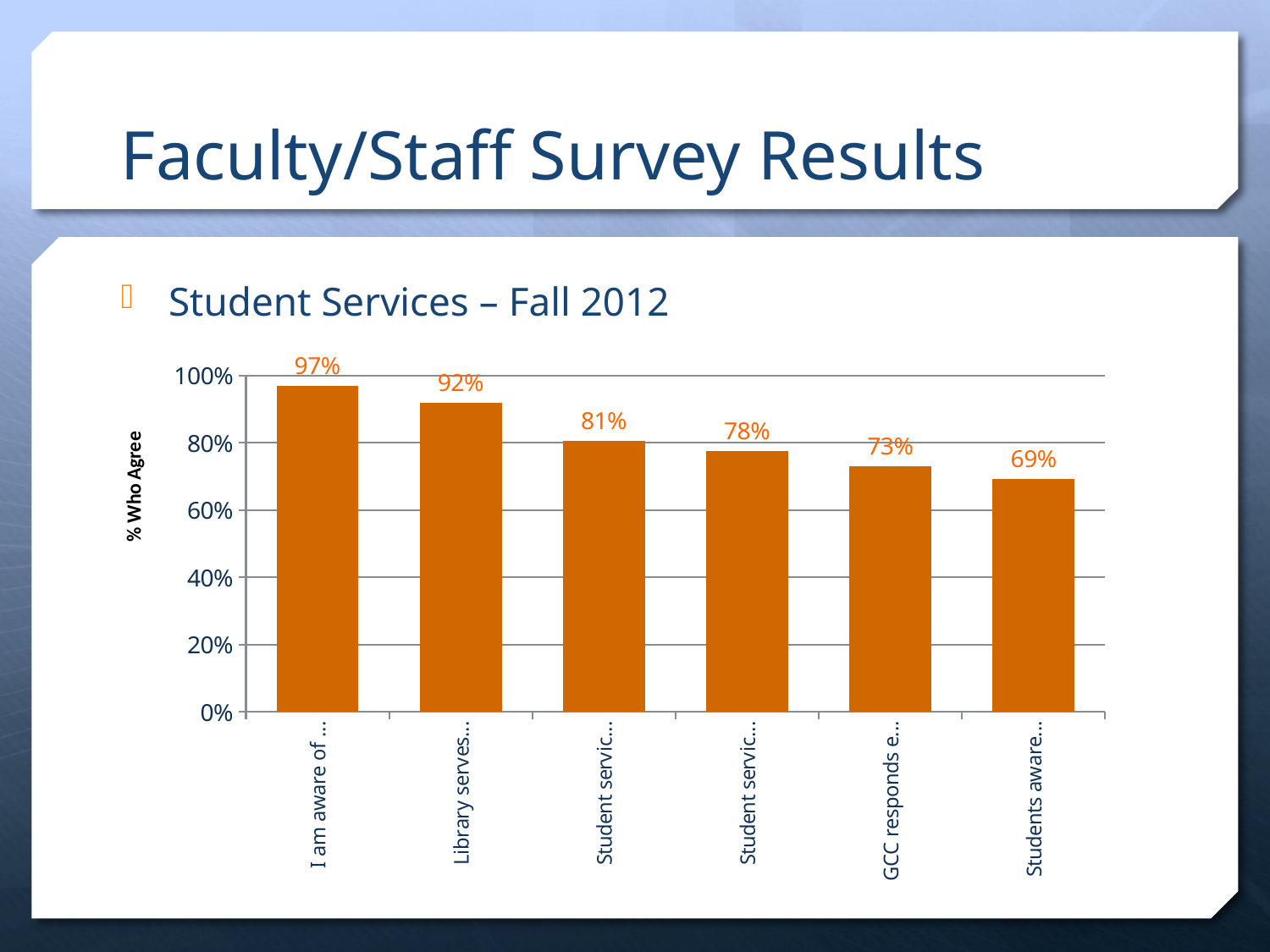
How many bars are plotted in the chart? 6 Which bar has the highest value? I am aware of... Which bar has the lowest value? Students aware... What is the value of the bar labelled "Library serves..."? 92% What type of chart is shown on the slide? bar chart What is the difference between the values for "I am aware of..." and "Students aware..."? 28% What is the value of the bar labelled "GCC responds e..."? 73% Which is larger, the value for "Library serves..." or the value for "GCC responds e..."? Library serves... Do the bar values rise or fall from left to right across the chart? fall What is the value of the bar labelled "Students aware..."? 69% What is the value of the third bar from the left? 81% What is the value of the bar labelled "I am aware of..."? 97%